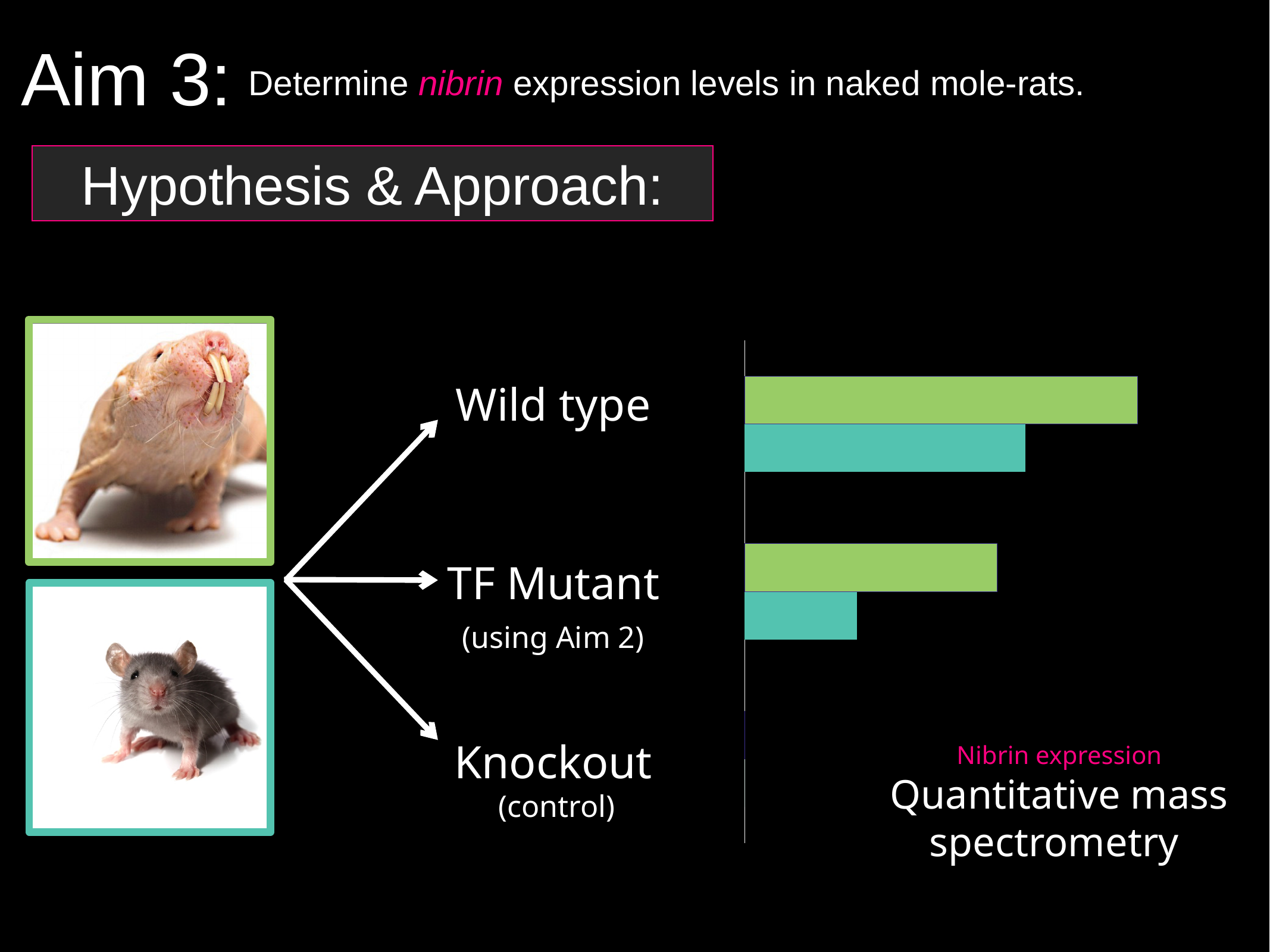
Do the bar lengths rise or fall going from Wild type to TF Mutant to Knockout? fall What two colours are used for the bars in the chart? green and teal How many categories are shown in the bar chart? 3 Is the green bar for Wild type longer or shorter than the green bar for TF Mutant? longer What quantity does the chart's horizontal axis represent, according to the label below it? Nibrin expression Which category shows the lowest Nibrin expression in the chart? Knockout What kind of chart is shown on the right of the slide? bar chart How many bars are drawn for the TF Mutant category? 2 Is the teal bar for TF Mutant longer or shorter than the teal bar for Wild type? shorter Which category has the longest teal bar in the chart? Wild type Within the Wild type category, which bar is longer, the green one or the teal one? green Which category has the longest green bar in the chart? Wild type